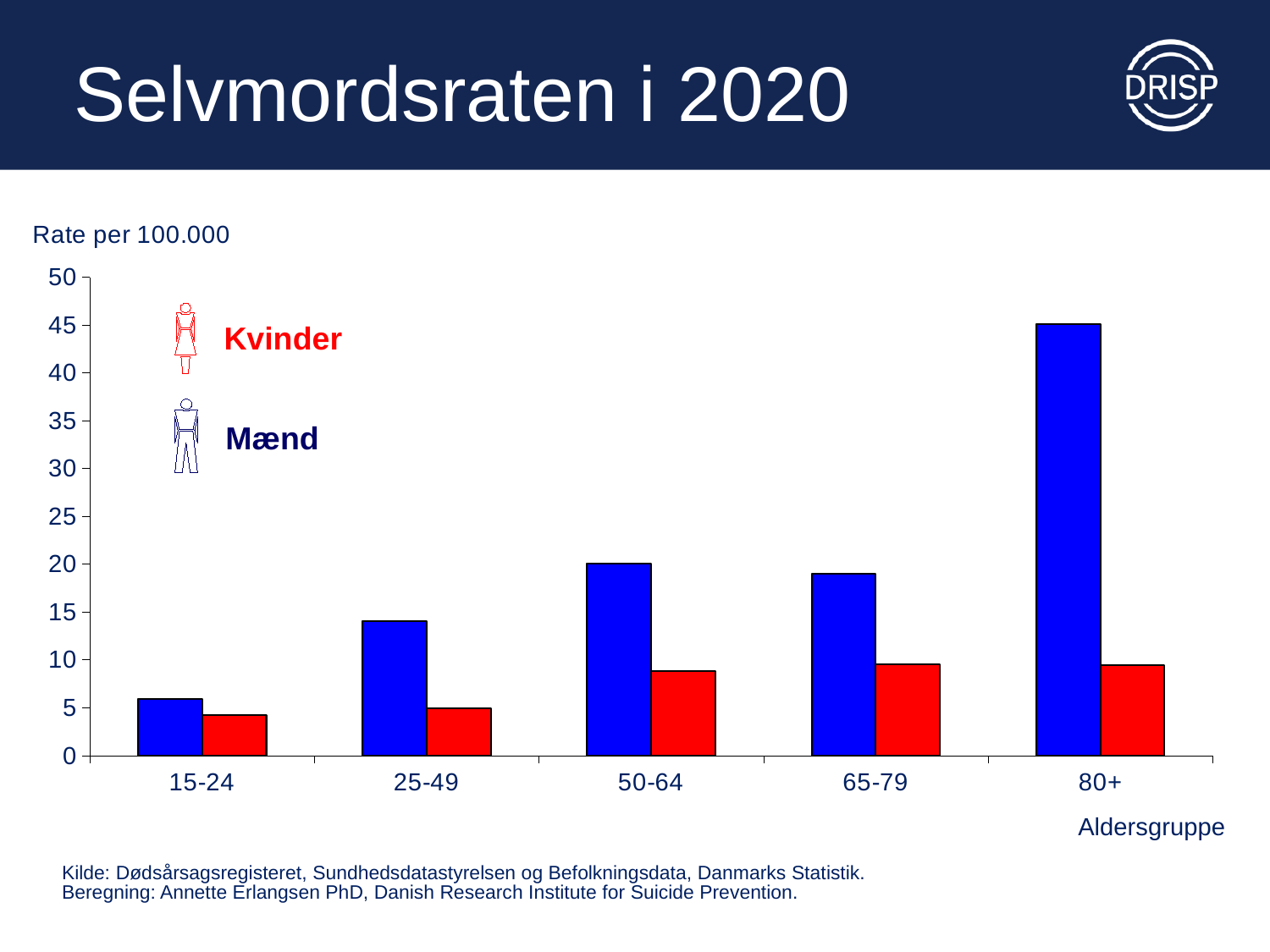
Which age group has the lowest value for Mænd? 15-24 Is the value for Kvinder in the 15-24 age group greater or less than 5? less Is the value for Mænd in the 80+ age group greater or less than 40? greater What is the label on the y axis of the chart? Rate per 100.000 Which age group has the highest value for Mænd? 80+ How many age groups are shown on the x axis? 5 Is the value for Mænd in the 25-49 age group greater or less than 10? greater In the 50-64 age group, which is larger, the value for Mænd or for Kvinder? Mænd How many series does the legend list? 2 What kind of chart is shown on the slide? bar chart Do the values for Mænd rise or fall from the 15-24 age group to the 50-64 age group? rise